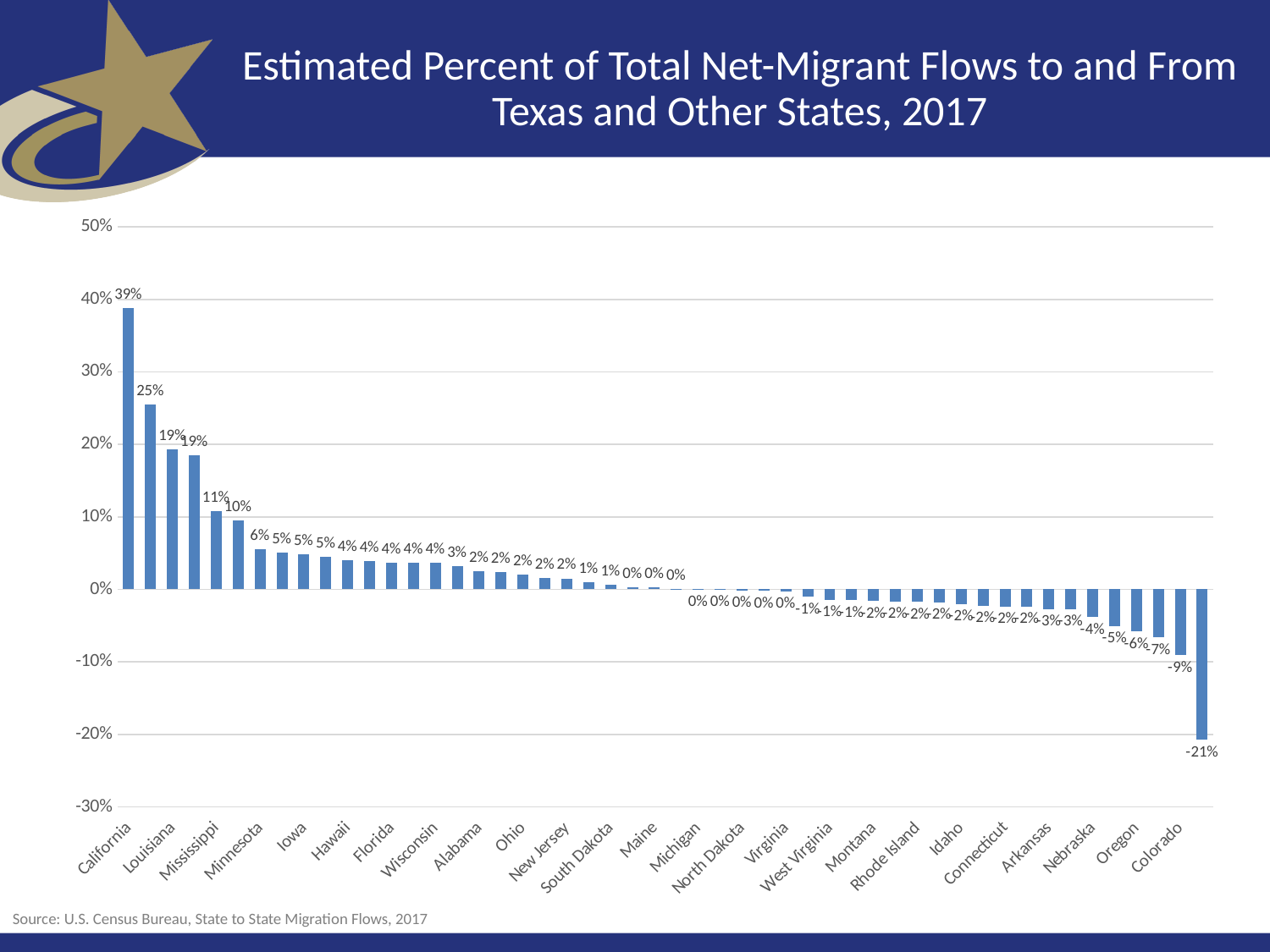
Which is larger, the value for California or the value for Colorado? California What is the estimated percent of total net-migrant flows for Colorado? -9% Is the value for California greater or less than 30%? greater Which state has the highest value in the chart? California What is the difference between the values for California and Colorado? 48 percentage points What type of chart is shown on the slide? bar chart What is the title of the chart? Estimated Percent of Total Net-Migrant Flows to and From Texas and Other States, 2017 Is the value for Colorado greater or less than -10%? greater What is the estimated percent of total net-migrant flows for California? 39% What source is cited for the chart data? U.S. Census Bureau, State to State Migration Flows, 2017 Do the values generally rise or fall from left to right along the x axis? fall